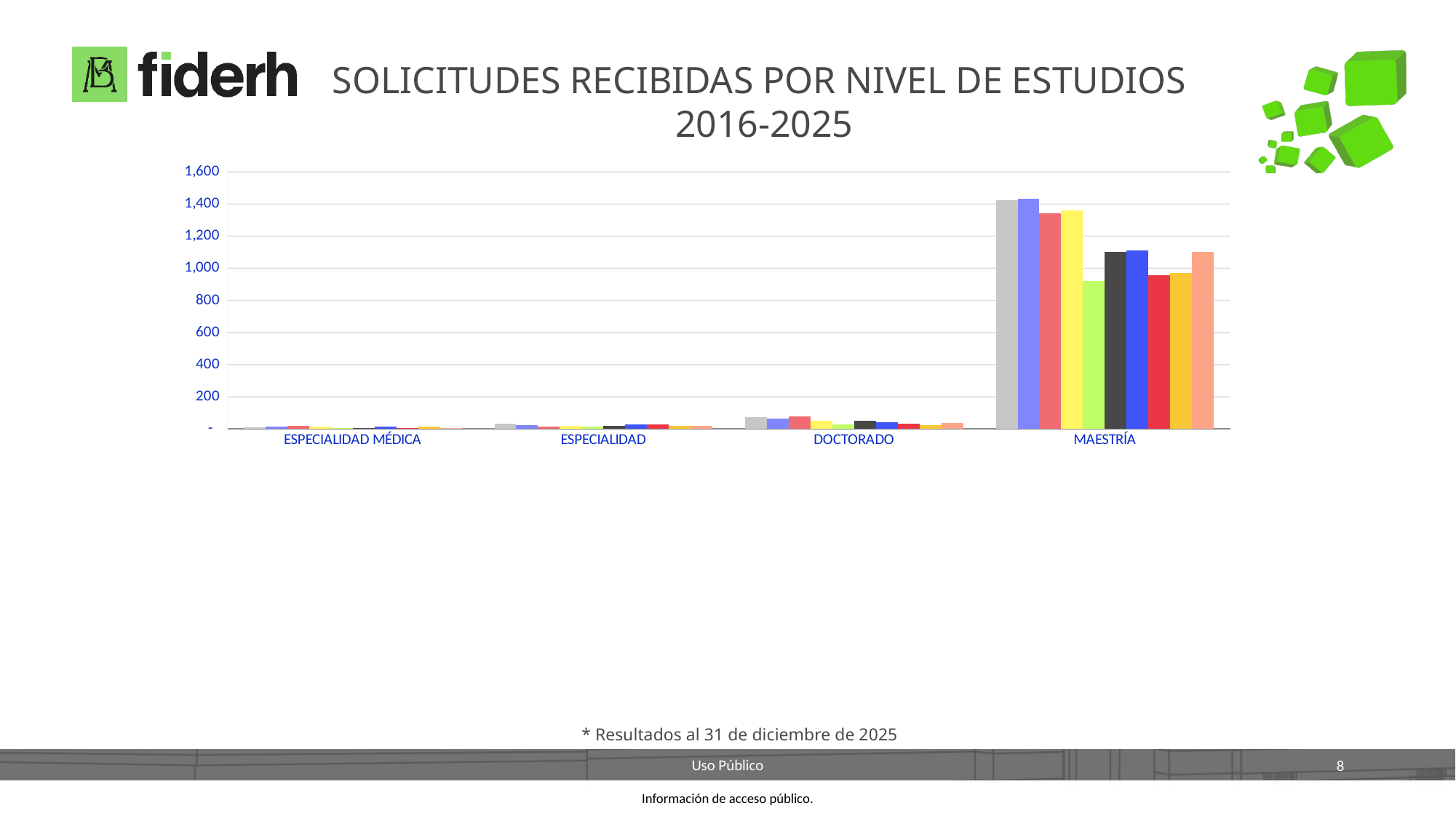
Are the values for DOCTORADO greater or less than 200? less What kind of chart is shown on the slide? bar chart What is the highest value shown on the y axis of the chart? 1,600 Which category has the lowest values in the chart? ESPECIALIDAD MÉDICA Are the values for MAESTRÍA greater or less than 800? greater How many categories are shown on the x axis of the chart? 4 Is the tallest bar for MAESTRÍA greater or less than 1,200? greater Which category has larger values, DOCTORADO or ESPECIALIDAD MÉDICA? DOCTORADO How many bars are plotted for each category in the chart? 10 Which category has larger values, MAESTRÍA or DOCTORADO? MAESTRÍA Which category has the highest values in the chart? MAESTRÍA What is the title of the chart on the slide? SOLICITUDES RECIBIDAS POR NIVEL DE ESTUDIOS 2016-2025